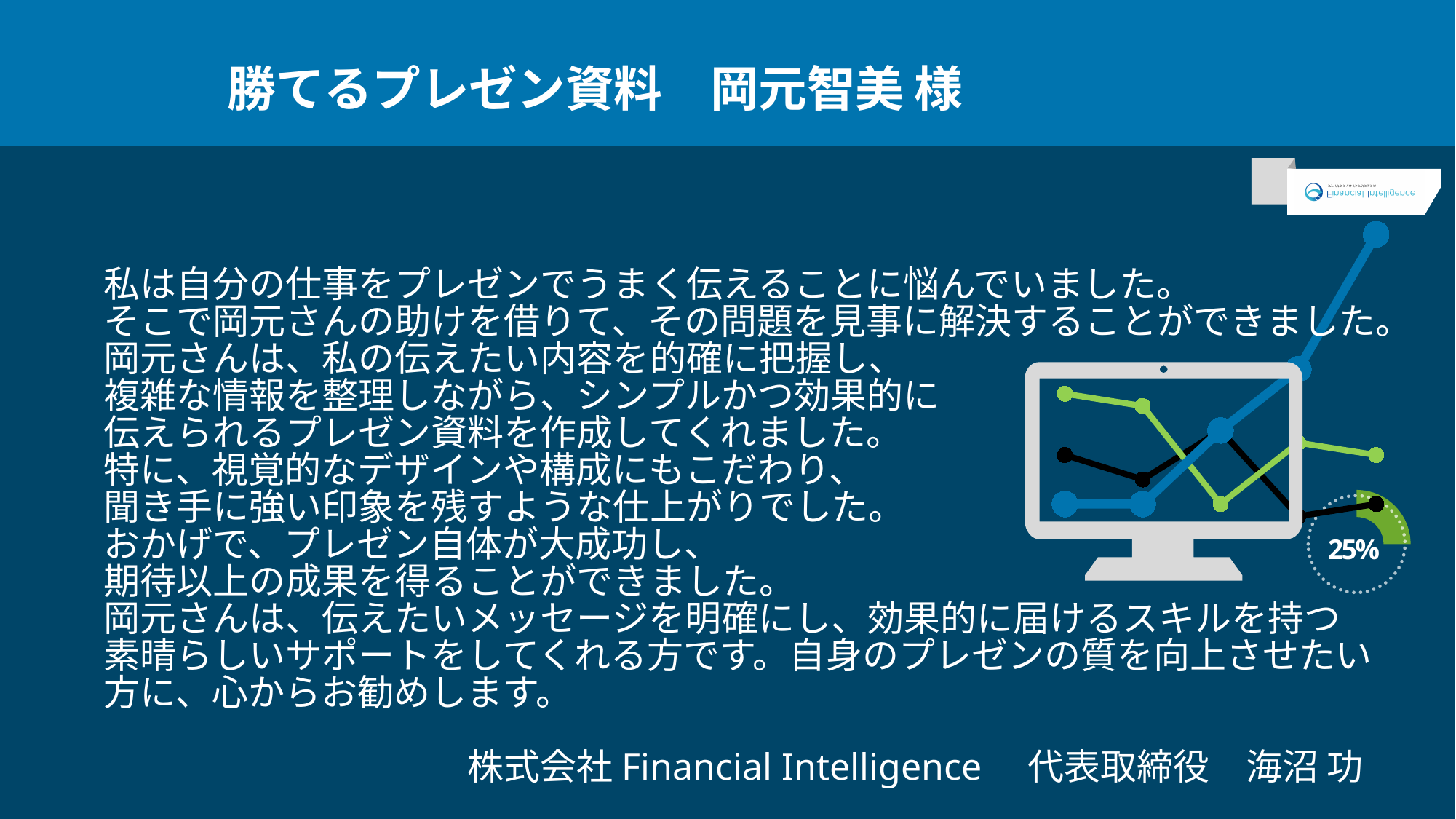
How many lines are plotted in the chart on the monitor illustration? 3 What colour is the line that rises steeply to the top right of the monitor illustration? blue What percentage is printed on the circular gauge graphic at the lower right of the slide? 25% What kind of chart is shown on the monitor illustration on the right of the slide? line chart Does the blue line in the monitor illustration rise or fall from left to right? rise